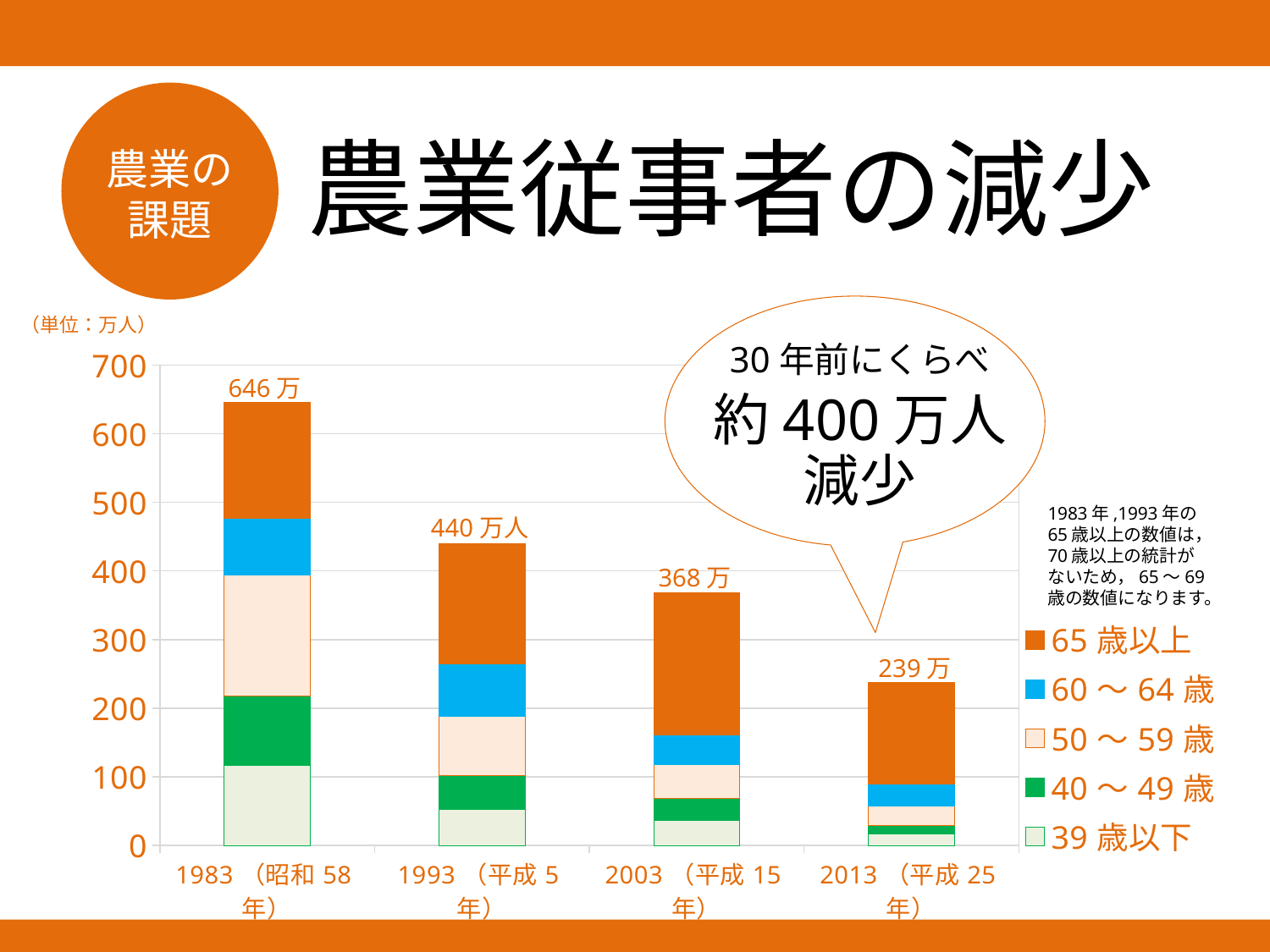
Which year has the lowest total number of agricultural workers? 2013 (平成25年) How many age-group series does the legend list? 5 What is the total labeled for the 1983 (昭和58年) bar? 646 万 What is the total labeled for the 2003 (平成15年) bar? 368 万 How many years (categories) are shown on the x axis? 4 What is the difference between the 1983 total and the 2013 total? 407 万 Which year has the highest total number of agricultural workers? 1983 (昭和58年) Which is larger, the total for 1993 or the total for 2003? 1993 What is the total labeled for the 1993 (平成5年) bar? 440 万人 Do the total values rise or fall from 1983 to 2013? fall What is the total labeled for the 2013 (平成25年) bar? 239 万 What type of chart is shown on the slide? stacked bar chart